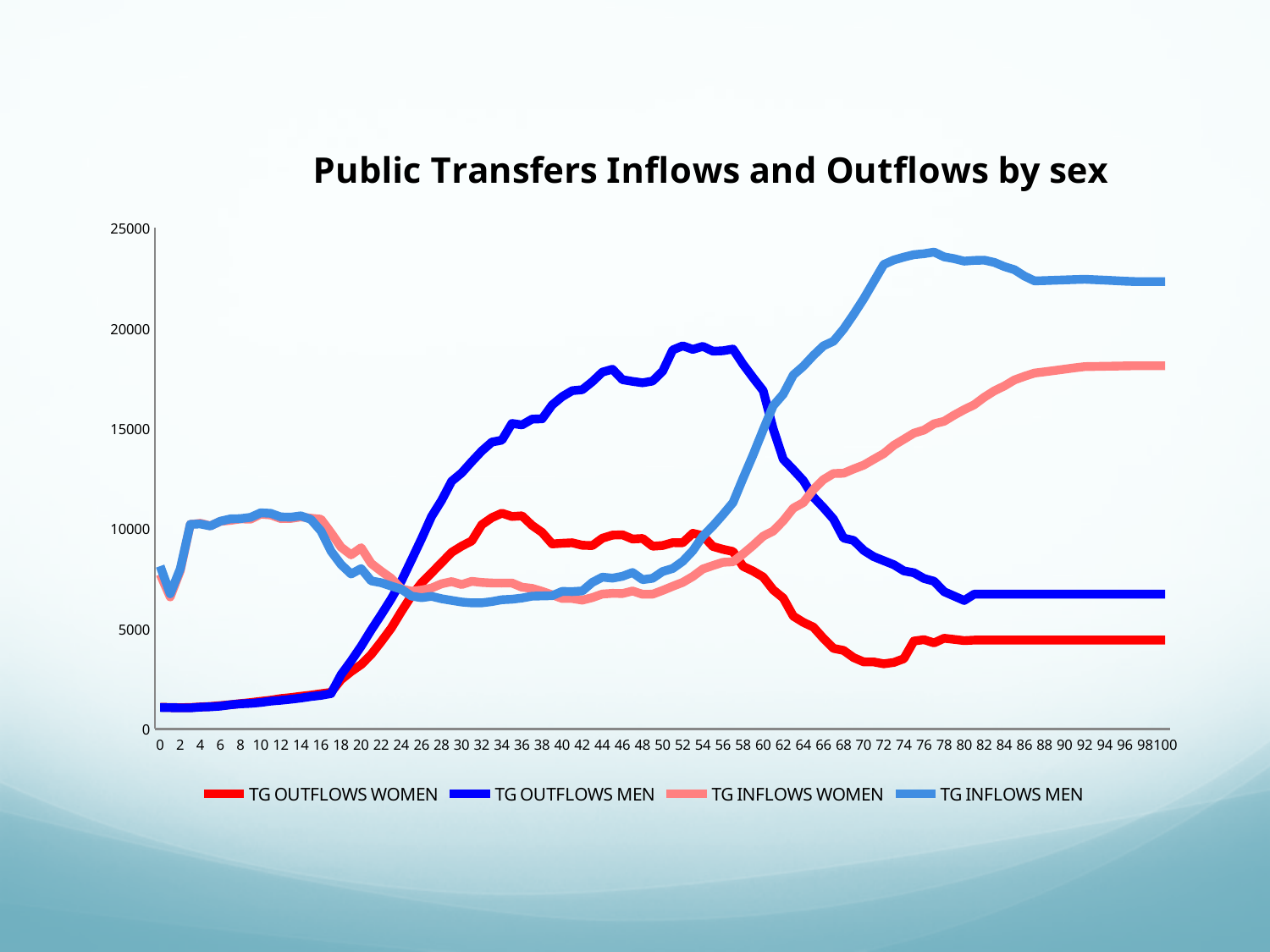
Does the TG INFLOWS WOMEN line rise or fall between age 60 and age 80? rise At age 90, which is larger: TG INFLOWS MEN or TG INFLOWS WOMEN? TG INFLOWS MEN At age 40, which is larger: TG OUTFLOWS MEN or TG OUTFLOWS WOMEN? TG OUTFLOWS MEN How many series does the legend list? 4 Which series reaches the highest value anywhere on the chart? TG INFLOWS MEN Is the value for TG OUTFLOWS MEN at age 100 greater or less than 10000? less Is the value for TG INFLOWS MEN at age 80 greater or less than 20000? greater Is the value for TG OUTFLOWS WOMEN at age 100 greater or less than 5000? less Which series has the lowest value at age 100? TG OUTFLOWS WOMEN What kind of chart is shown on the slide? Line chart What is the title of the chart? Public Transfers Inflows and Outflows by sex